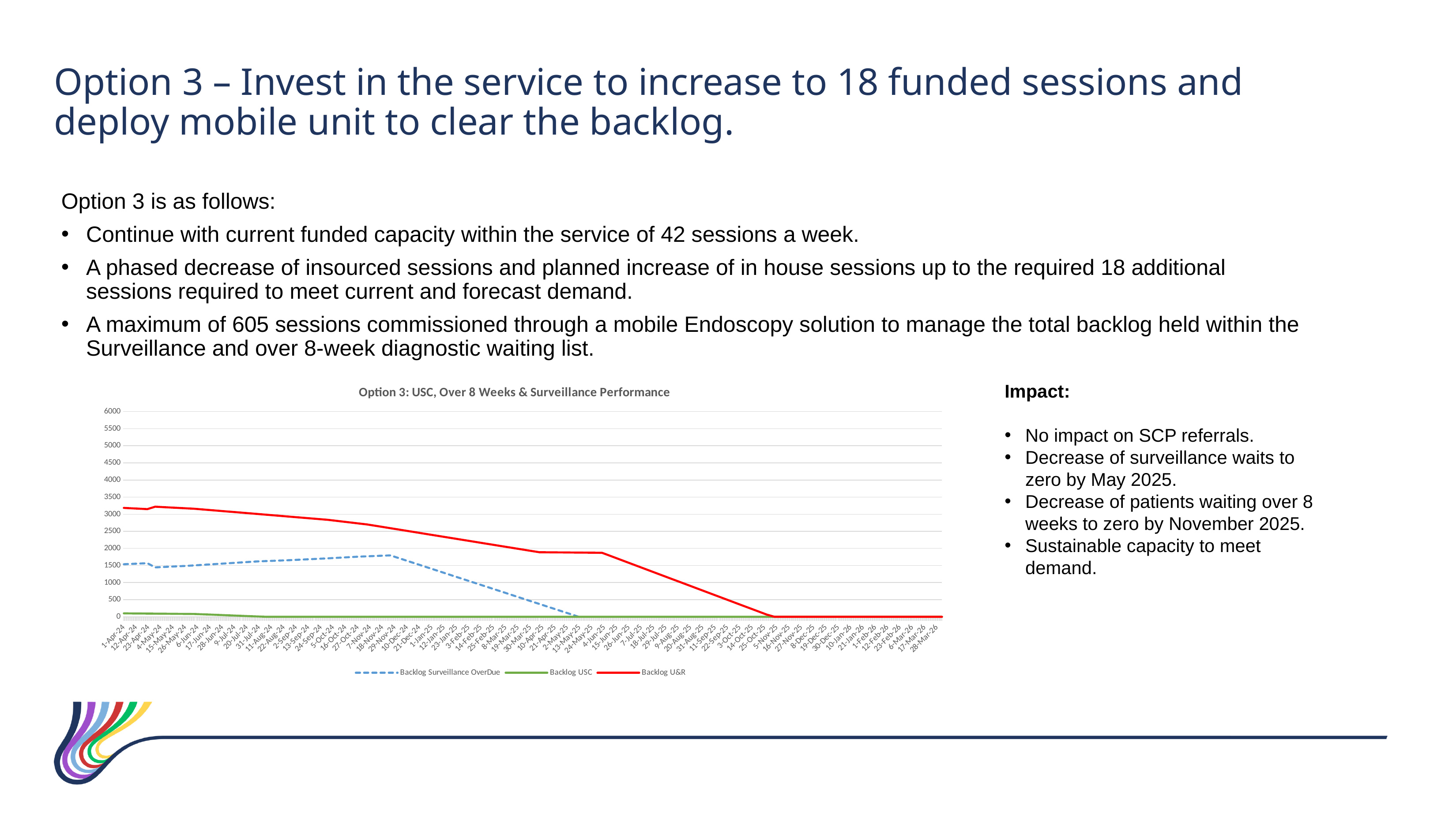
Which series has the highest value at 1-Apr-24? Backlog U&R Is the value for Backlog Surveillance OverDue at 1-Apr-24 greater or less than 1000? greater Is the value for Backlog USC at 1-Apr-24 greater or less than 500? less Is the value for Backlog U&R at 1-Apr-24 greater or less than 2500? greater Does the Backlog U&R series rise or fall over the period shown on the x axis? fall What is the title of the chart? Option 3: USC, Over 8 Weeks & Surveillance Performance What kind of chart is shown on the slide? line chart At 1-Apr-24, which is higher: Backlog U&R or Backlog Surveillance OverDue? Backlog U&R How many series does the chart legend list? 3 Which series in the chart is drawn as a dashed line? Backlog Surveillance OverDue